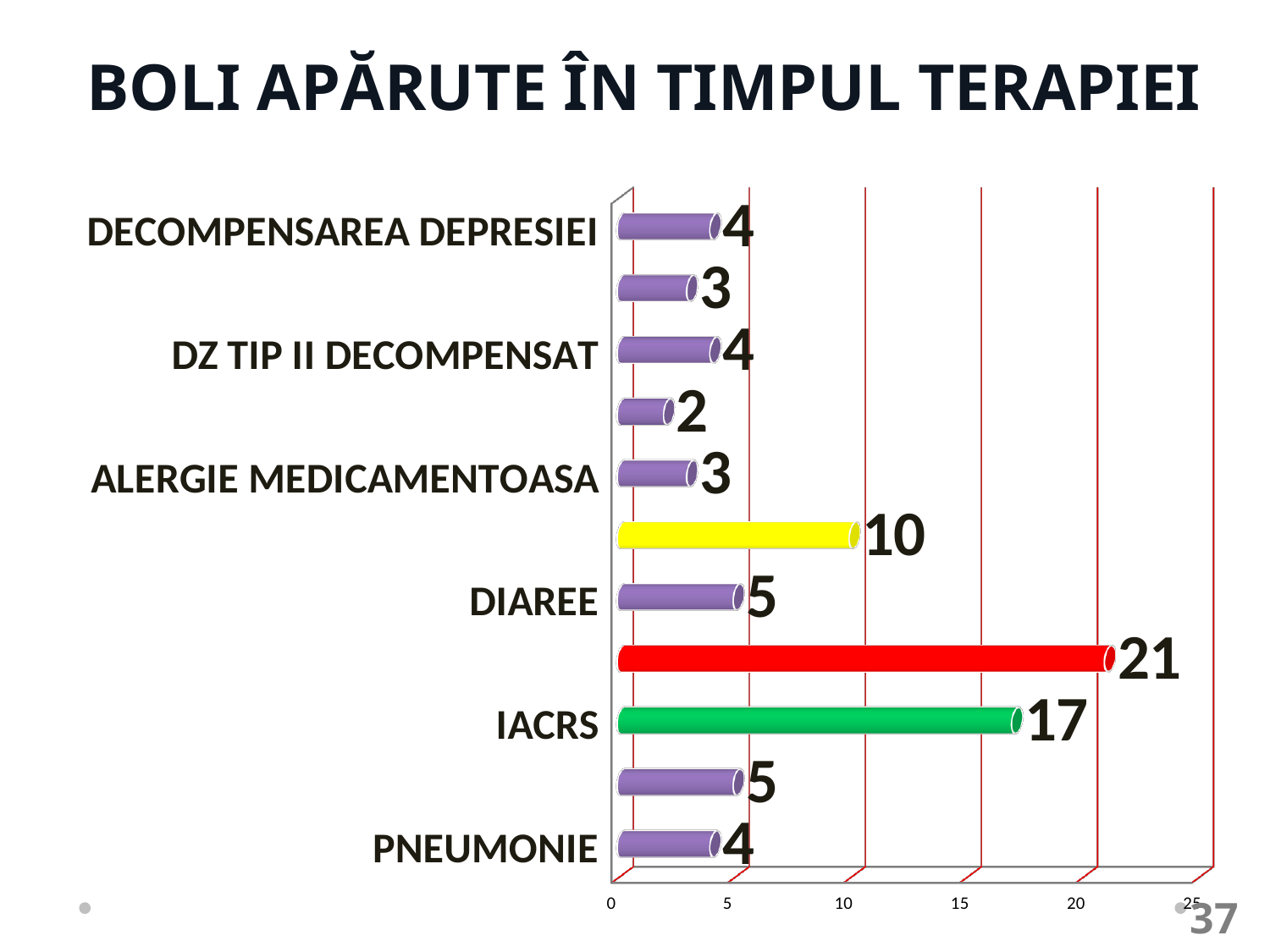
What is the difference between the values for IACRS and DIAREE? 12 What is the largest value shown by any bar in the chart? 21 What value does the red bar show? 21 What is the value for DIAREE? 5 What is the title of the slide? BOLI APĂRUTE ÎN TIMPUL TERAPIEI What is the value for ALERGIE MEDICAMENTOASA? 3 What is the value for PNEUMONIE? 4 What kind of chart is shown on the slide? bar chart How many bars are plotted in the chart? 11 Which is larger, the value for IACRS or the value for PNEUMONIE? IACRS What is the value for IACRS? 17 What is the value for DZ TIP II DECOMPENSAT? 4